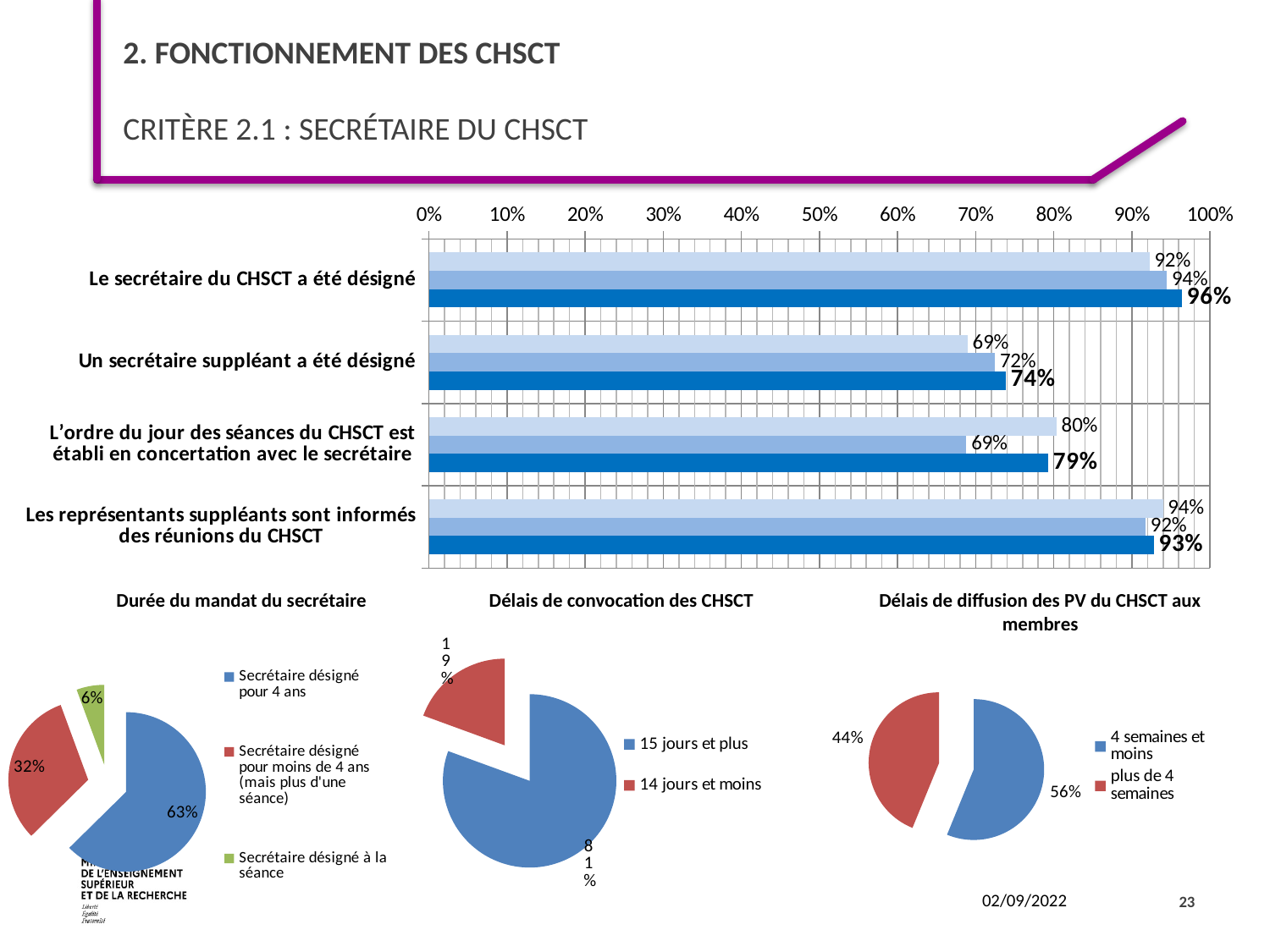
In the horizontal bar chart at the top, what is the difference between the dark blue bar values for "Le secrétaire du CHSCT a été désigné" and "Un secrétaire suppléant a été désigné"? 22% In the pie chart "Durée du mandat du secrétaire", what share is "Secrétaire désigné pour 4 ans"? 63% In the horizontal bar chart at the top, what is the value of the light blue (top) bar for "L’ordre du jour des séances du CHSCT est établi en concertation avec le secrétaire"? 80% In the pie chart "Délais de convocation des CHSCT", what share is "15 jours et plus"? 81% How many entries does the legend of the pie chart "Durée du mandat du secrétaire" list? 3 In the horizontal bar chart at the top, what is the value of the dark blue (bottom) bar for "Le secrétaire du CHSCT a été désigné"? 96% In the horizontal bar chart at the top, how many categories are shown? 4 In the horizontal bar chart at the top, which category has the lowest value for the dark blue (bottom) bar? Un secrétaire suppléant a été désigné What type of chart is the chart at the top of the slide? Bar chart In the pie chart "Délais de diffusion des PV du CHSCT aux membres", which is larger: "4 semaines et moins" or "plus de 4 semaines"? 4 semaines et moins In the horizontal bar chart at the top, what is the value of the medium blue (middle) bar for "Un secrétaire suppléant a été désigné"? 72% In the pie chart "Durée du mandat du secrétaire", which slice is the smallest? Secrétaire désigné à la séance